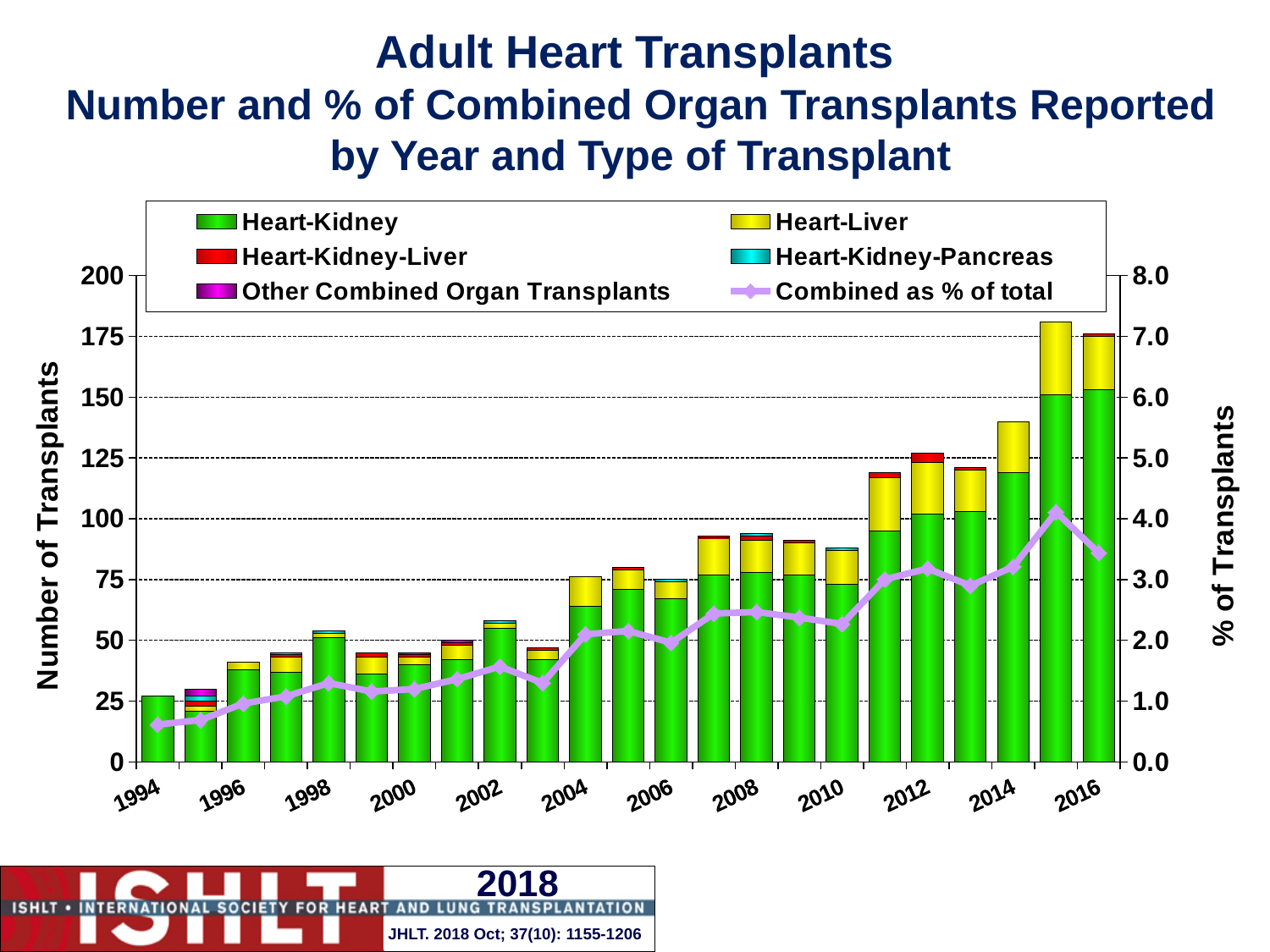
Overall, does the number of combined organ transplants rise or fall from 1994 to 2016? Rise What is the label of the right-hand y axis? % of Transplants Is the 'Combined as % of total' value for 2015 greater or less than 3.0? greater Is the total number of combined transplants in 1994 greater or less than 50? less How many years (bars) are plotted along the x axis? 23 Which year has the shortest bar for total combined organ transplants? 1994 Is the total number of combined transplants in 2015 greater or less than 150? greater What kind of chart is shown on the slide? A stacked bar chart with a line overlay Which year has the tallest bar for total combined organ transplants? 2015 Which year has a larger total number of combined transplants, 2011 or 2014? 2014 How many series does the legend list? 6